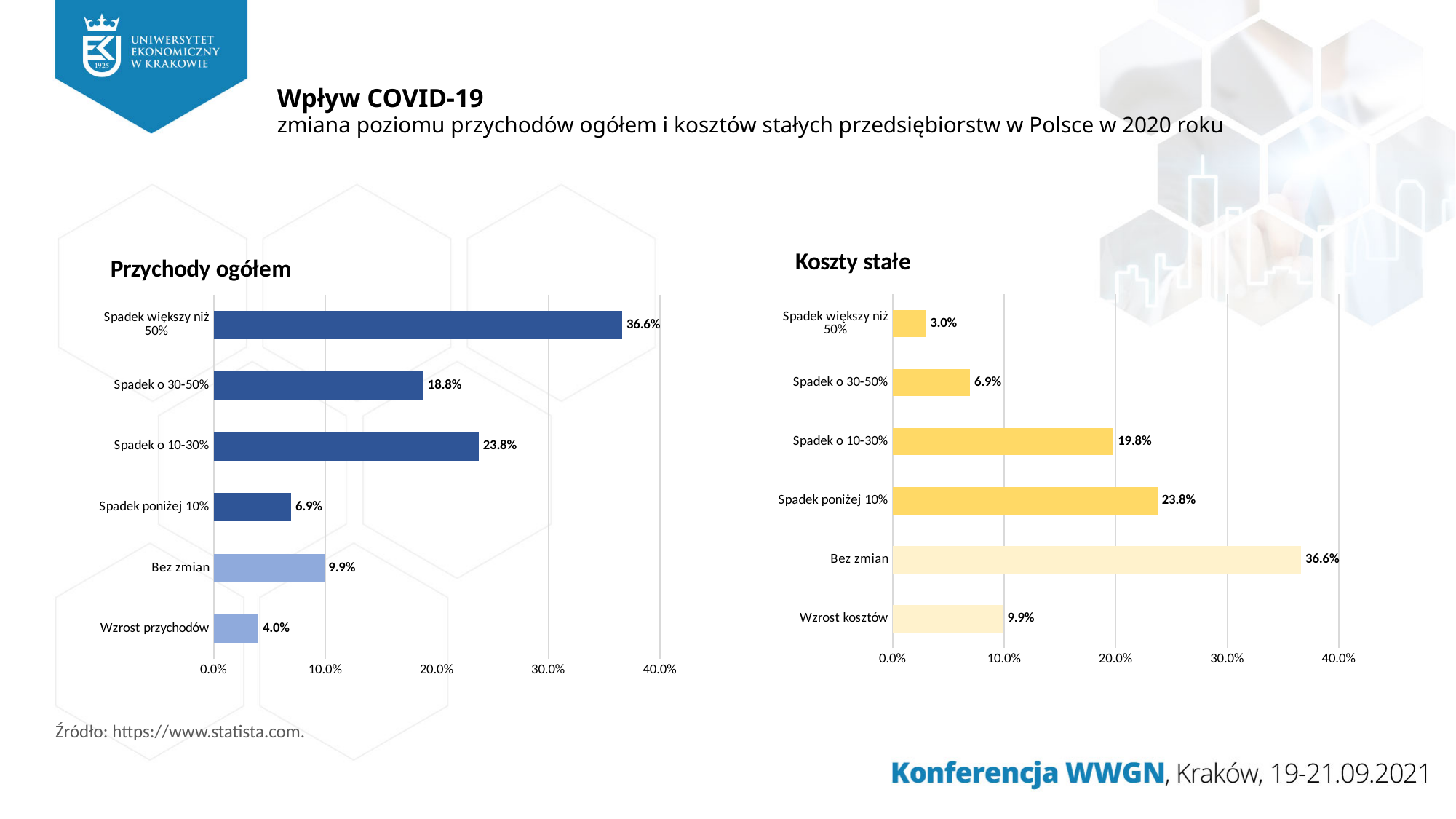
In the 'Koszty stałe' chart, which category has the highest value? Bez zmian In the 'Koszty stałe' chart, is the value for 'Spadek o 10-30%' greater or less than 10.0%? greater In the 'Koszty stałe' chart, what is the difference between 'Spadek poniżej 10%' and 'Spadek o 10-30%'? 4.0% In the 'Przychody ogółem' chart, which category has the lowest value? Wzrost przychodów In the 'Przychody ogółem' chart, what is the difference between 'Spadek o 10-30%' and 'Spadek o 30-50%'? 5.0% What is the value of the highest tick on the x axis of the 'Przychody ogółem' chart? 40.0% In the 'Koszty stałe' chart, what is the value for 'Bez zmian'? 36.6% In the 'Przychody ogółem' chart, what is the value for 'Spadek większy niż 50%'? 36.6% How many categories does the 'Przychody ogółem' chart show? 6 In the 'Przychody ogółem' chart, which is larger: 'Bez zmian' or 'Spadek poniżej 10%'? Bez zmian In the 'Koszty stałe' chart, which category has the lowest value? Spadek większy niż 50% What kind of chart is the 'Koszty stałe' chart? Bar chart